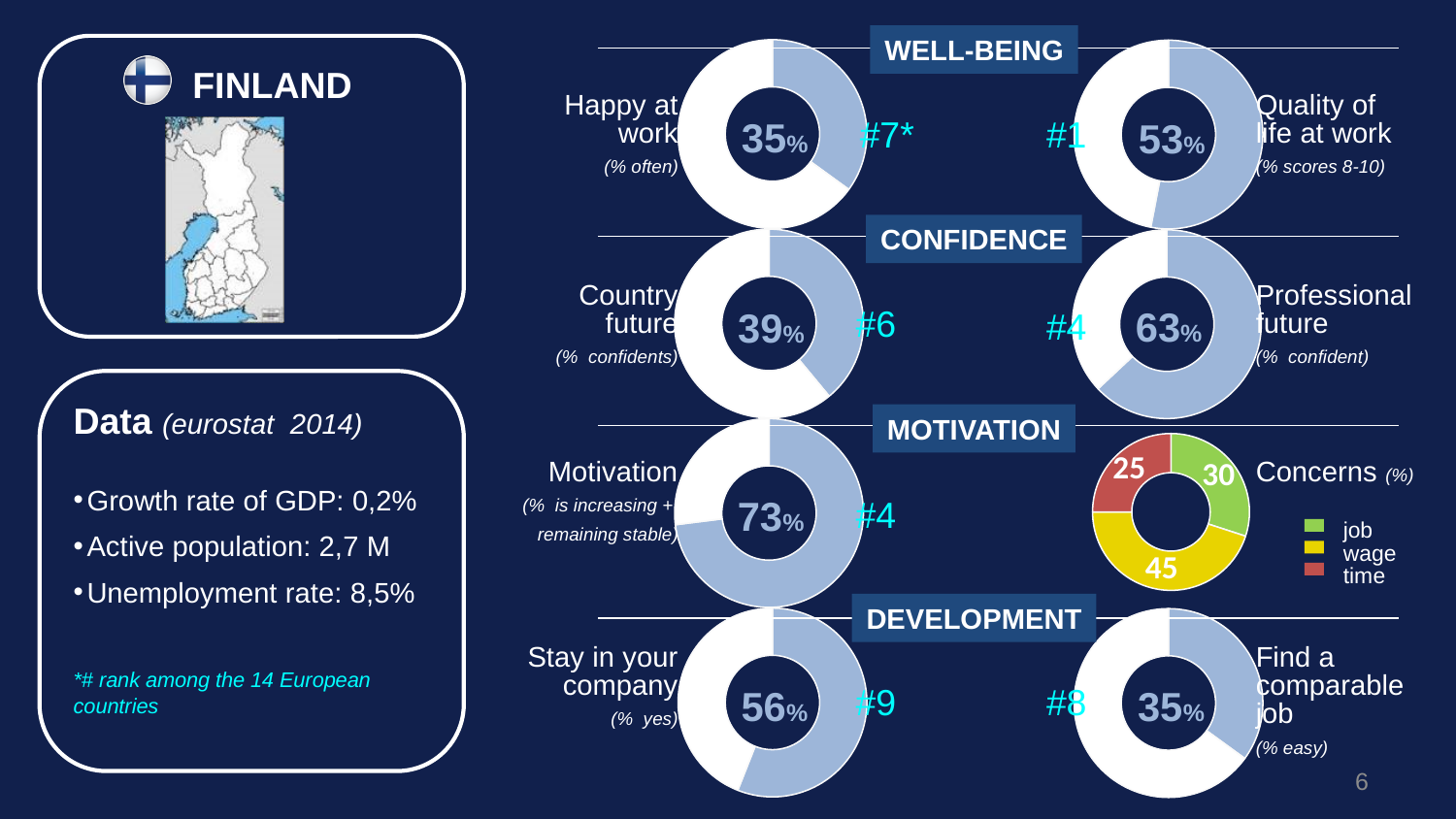
On the 'Professional future' donut chart, what percentage is shown? 63% What kind of chart is used for 'Stay in your company'? Donut chart On the 'Quality of life at work' donut chart, what percentage is shown? 53% On the 'Concerns (%)' chart, what is the value for wage? 45 On the 'Concerns (%)' chart, what is the difference between the job and time values? 5 On the 'Happy at work' donut chart, what percentage is shown? 35% On the 'Concerns (%)' chart, which category has the largest share? wage On the 'Concerns (%)' chart, how many categories does the legend list? 3 On the 'Motivation' donut chart, what percentage is shown? 73% Which is larger: the 'Country future' percentage or the 'Professional future' percentage? Professional future What is the difference between the 'Stay in your company' percentage and the 'Find a comparable job' percentage? 21% On the 'Concerns (%)' chart, which category has the smallest share? time